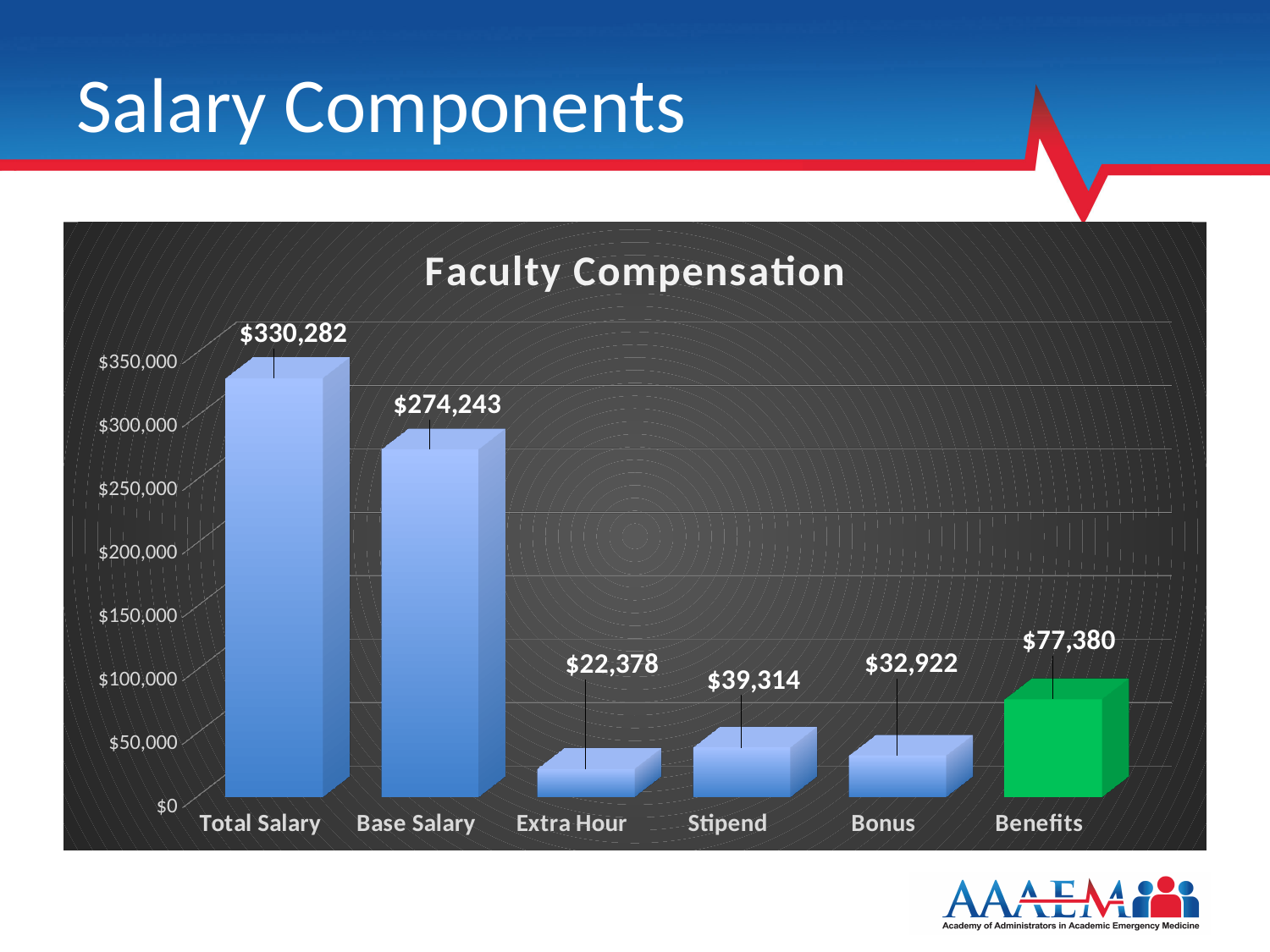
What is the difference between Total Salary and Base Salary in the Faculty Compensation chart? $56,039 Which is larger in the Faculty Compensation chart, Bonus or Benefits? Benefits Which category has the highest value in the Faculty Compensation chart? Total Salary What is the value for Base Salary in the Faculty Compensation chart? $274,243 Which category has the lowest value in the Faculty Compensation chart? Extra Hour What is the difference between Stipend and Bonus in the Faculty Compensation chart? $6,392 Is the value for Base Salary greater or less than $250,000 in the Faculty Compensation chart? greater Which bar in the Faculty Compensation chart is coloured green rather than blue? Benefits How many categories are shown in the Faculty Compensation chart? 6 What is the value for Benefits in the Faculty Compensation chart? $77,380 What is the value for Stipend in the Faculty Compensation chart? $39,314 What kind of chart is the Faculty Compensation chart? Bar chart